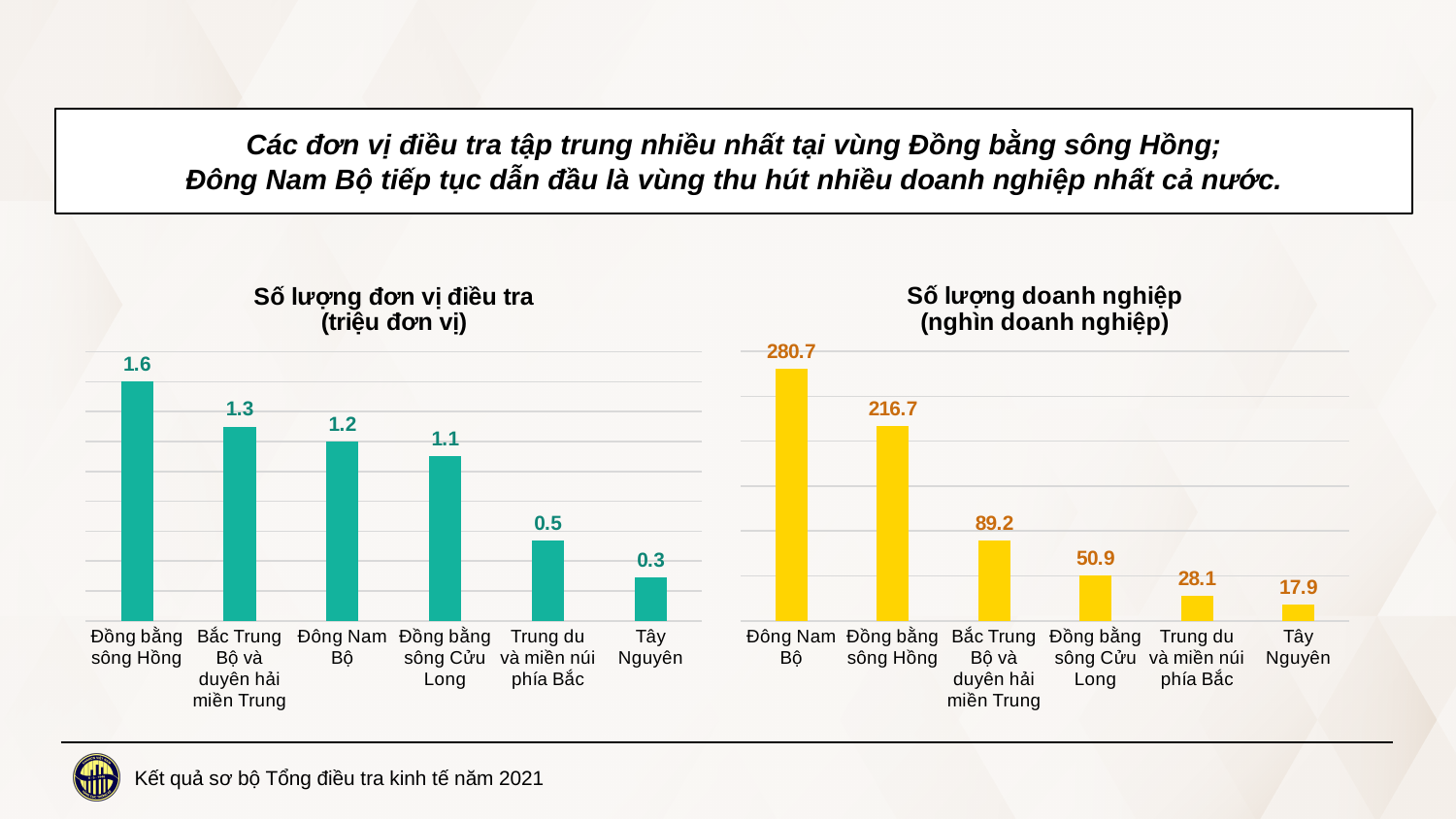
What type of chart is the chart titled "Số lượng doanh nghiệp (nghìn doanh nghiệp)"? bar chart In the chart titled "Số lượng đơn vị điều tra (triệu đơn vị)", how many regions are shown? 6 In the chart titled "Số lượng doanh nghiệp (nghìn doanh nghiệp)", what is the difference between Đông Nam Bộ and Đồng bằng sông Hồng? 64 In the chart titled "Số lượng doanh nghiệp (nghìn doanh nghiệp)", which region has the highest value? Đông Nam Bộ What colour are the bars in the chart titled "Số lượng đơn vị điều tra (triệu đơn vị)"? teal/green In the chart titled "Số lượng doanh nghiệp (nghìn doanh nghiệp)", what is the value for Bắc Trung Bộ và duyên hải miền Trung? 89.2 In the chart titled "Số lượng doanh nghiệp (nghìn doanh nghiệp)", what is the value for Tây Nguyên? 17.9 In the chart titled "Số lượng đơn vị điều tra (triệu đơn vị)", do the values rise or fall from left to right? fall In the chart titled "Số lượng đơn vị điều tra (triệu đơn vị)", which region has the lowest value? Tây Nguyên In the chart titled "Số lượng doanh nghiệp (nghìn doanh nghiệp)", which is larger: Đồng bằng sông Cửu Long or Trung du và miền núi phía Bắc? Đồng bằng sông Cửu Long In the chart titled "Số lượng đơn vị điều tra (triệu đơn vị)", what is the value for Đồng bằng sông Hồng? 1.6 In the chart titled "Số lượng đơn vị điều tra (triệu đơn vị)", what is the difference between Đồng bằng sông Hồng and Trung du và miền núi phía Bắc? 1.1